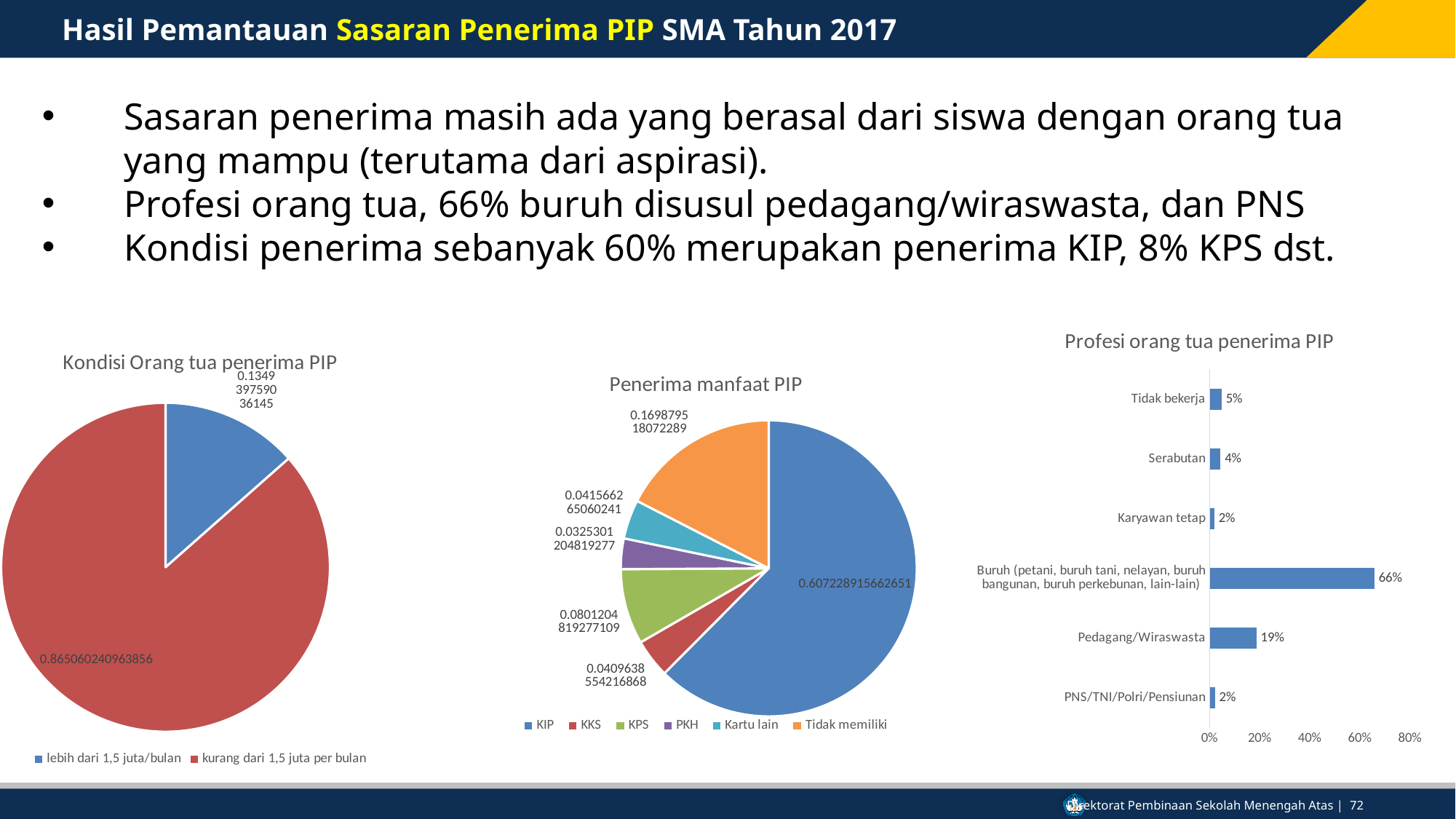
In the 'Profesi orang tua penerima PIP' chart, which category has the highest value? Buruh (petani, buruh tani, nelayan, buruh bangunan, buruh perkebunan, lain-lain) What kind of chart is 'Kondisi Orang tua penerima PIP'? Pie chart In the 'Kondisi Orang tua penerima PIP' chart, what is the value shown for 'kurang dari 1,5 juta per bulan'? 0.865060240963856 In the 'Penerima manfaat PIP' chart, what is the value shown for KIP? 0.607228915662651 In the 'Profesi orang tua penerima PIP' chart, what is the value for Pedagang/Wiraswasta? 19% What kind of chart is 'Profesi orang tua penerima PIP'? Bar chart In the 'Profesi orang tua penerima PIP' chart, how many categories are shown? 6 In the 'Profesi orang tua penerima PIP' chart, what is the difference between the values for Buruh and Pedagang/Wiraswasta? 47% In the 'Profesi orang tua penerima PIP' chart, which is larger, Serabutan or Karyawan tetap? Serabutan In the 'Penerima manfaat PIP' chart, which category has the largest slice? KIP How many series does the legend of the 'Penerima manfaat PIP' chart list? 6 In the 'Profesi orang tua penerima PIP' chart, what is the value for Tidak bekerja? 5%